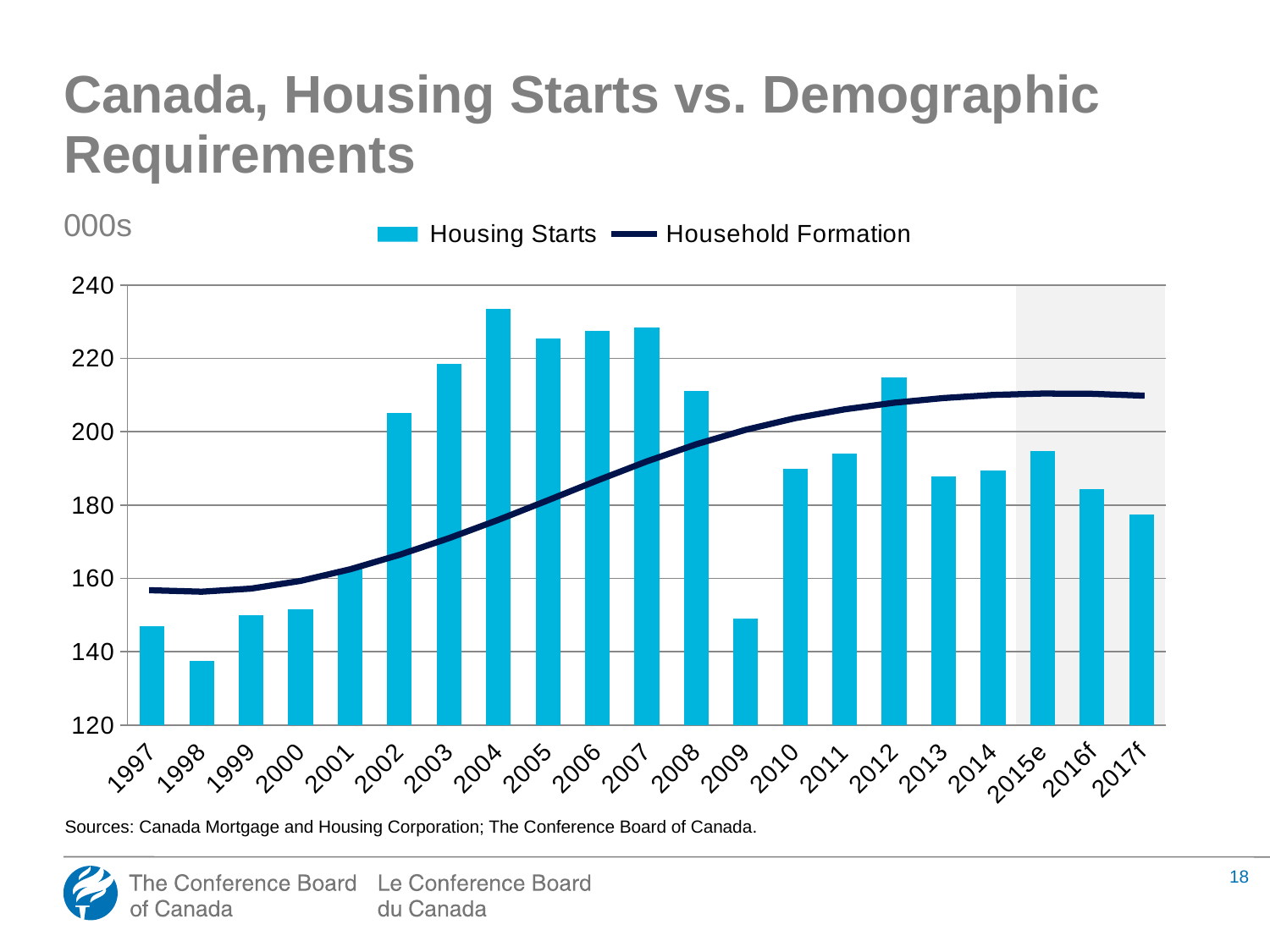
How many years are shown on the x axis? 21 What unit is indicated above the chart's y axis? 000s Which year has the highest Housing Starts value? 2004 Is the Housing Starts value for 2009 greater or less than 160? less Is the Housing Starts value for 2017f greater or less than 180? less How many series does the legend list? 2 Is the Housing Starts value for 2012 greater or less than 200? greater Does the Household Formation line rise or fall from 1997 to 2014? rise Which year has the lowest Housing Starts value? 1998 Which year has the larger Housing Starts value, 2002 or 2009? 2002 What kind of chart is used to show Housing Starts? bar chart